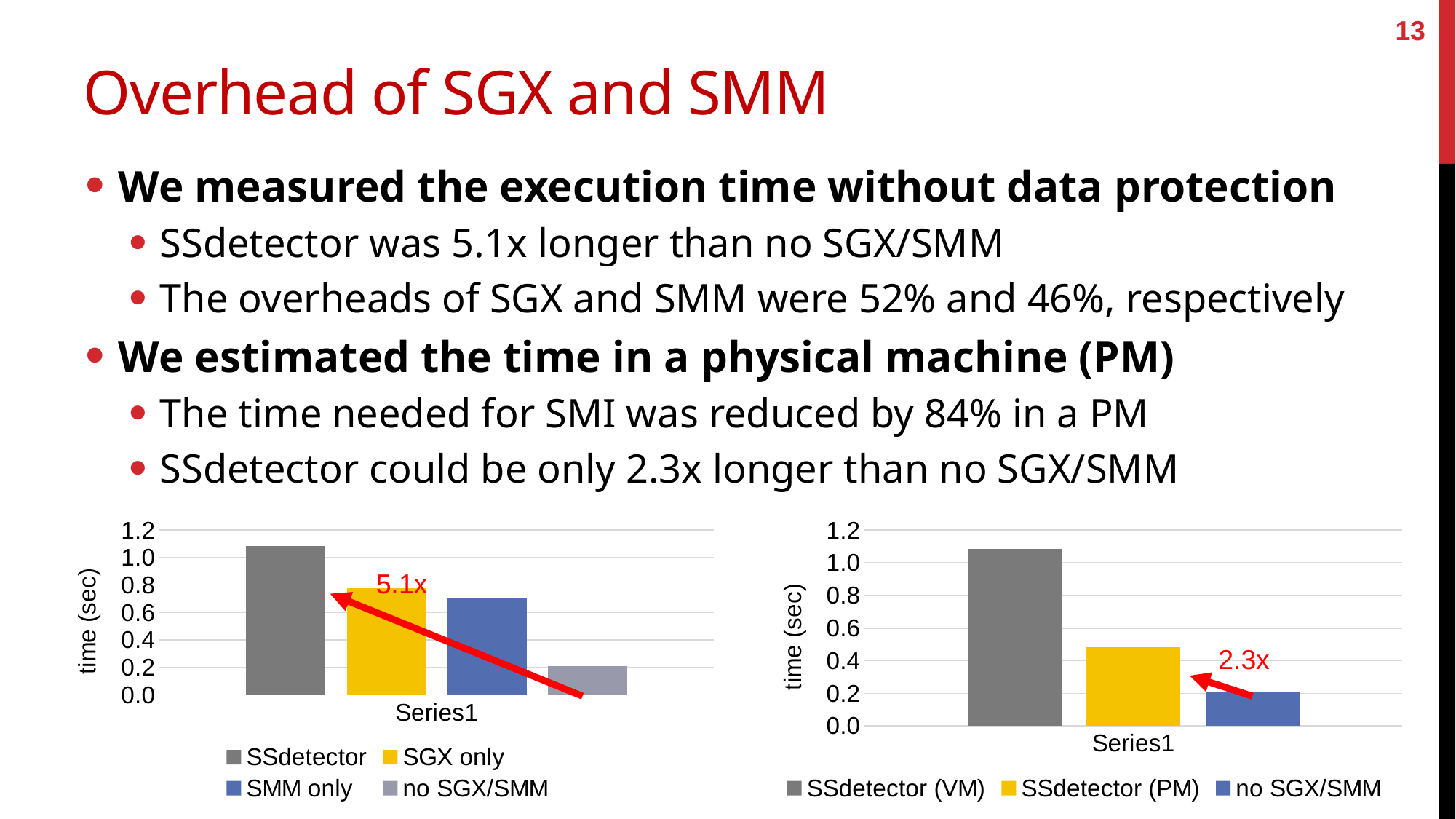
In the right chart, which series has the highest bar? SSdetector (VM) What is the y-axis label of the left chart? time (sec) In the left chart, which series has the highest bar? SSdetector In the right chart, is the value for SSdetector (PM) greater or less than 0.6? less In the left chart, is the value for SSdetector greater or less than 1.0? greater What kind of chart is the left chart? bar chart In the right chart, which is larger, SSdetector (VM) or SSdetector (PM)? SSdetector (VM) In the left chart, which series has the lowest bar? no SGX/SMM In the right chart, which series has the lowest bar? no SGX/SMM How many series does the legend of the left chart list? 4 In the left chart, is the value for no SGX/SMM greater or less than 0.4? less How many series does the legend of the right chart list? 3